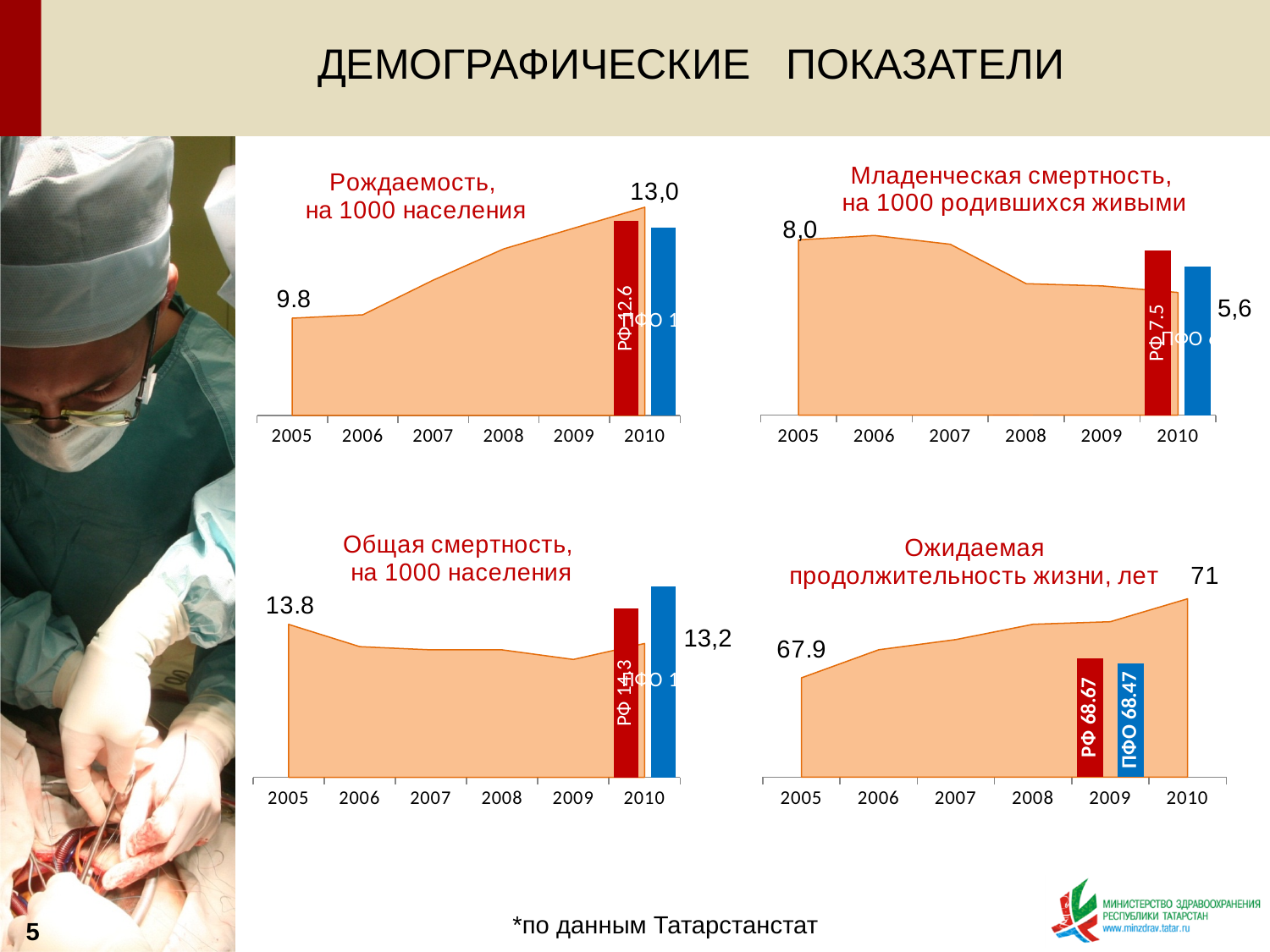
In the chart 'Младенческая смертность, на 1000 родившихся живыми', do the values rise or fall from 2005 to 2010? fall In the chart 'Рождаемость, на 1000 населения', do the values rise or fall from 2005 to 2010? rise How many years are shown on the x axis of the chart 'Ожидаемая продолжительность жизни, лет'? 6 In the chart 'Ожидаемая продолжительность жизни, лет', which is larger, the РФ value or the ПФО value? РФ In the chart 'Общая смертность, на 1000 населения', what is the value for 2010? 13,2 In the chart 'Рождаемость, на 1000 населения', what value is shown for РФ? 12.6 In the chart 'Рождаемость, на 1000 населения', what is the value for 2005? 9.8 In the chart 'Рождаемость, на 1000 населения', what is the value for 2010? 13,0 In the chart 'Младенческая смертность, на 1000 родившихся живыми', what is the value for 2010? 5,6 In the chart 'Младенческая смертность, на 1000 родившихся живыми', what is the difference between the 2005 and 2010 values? 2,4 In the chart 'Ожидаемая продолжительность жизни, лет', what is the value shown for ПФО? 68.47 In the chart 'Общая смертность, на 1000 населения', what is the value for 2005? 13.8